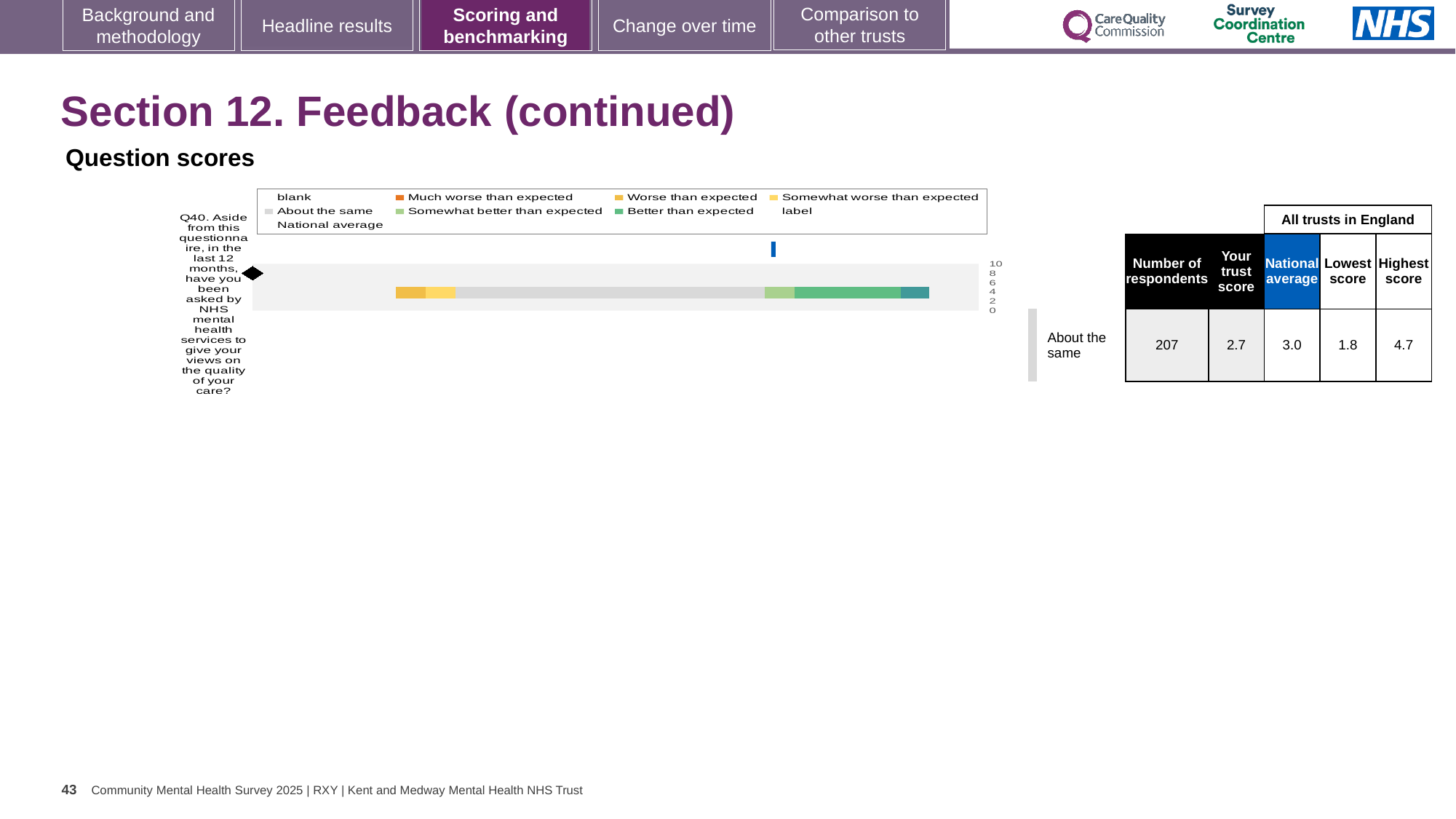
Which is larger for Q40, the trust's score or the national average? national average What is the number of respondents shown for Q40? 207 What benchmark category is shown next to the Q40 bar chart? About the same What is the highest score among all trusts in England for Q40? 4.7 Which question number is plotted in the bar chart? Q40 How many questions are plotted in the bar chart on the slide? 1 What kind of chart is shown for Q40 on the slide? bar chart What is the national average score for Q40? 3.0 What is the difference between the national average and the trust's score for Q40? 0.3 What is the lowest score among all trusts in England for Q40? 1.8 What is the trust's score for Q40? 2.7 What is the difference between the highest and lowest scores among all trusts in England for Q40? 2.9